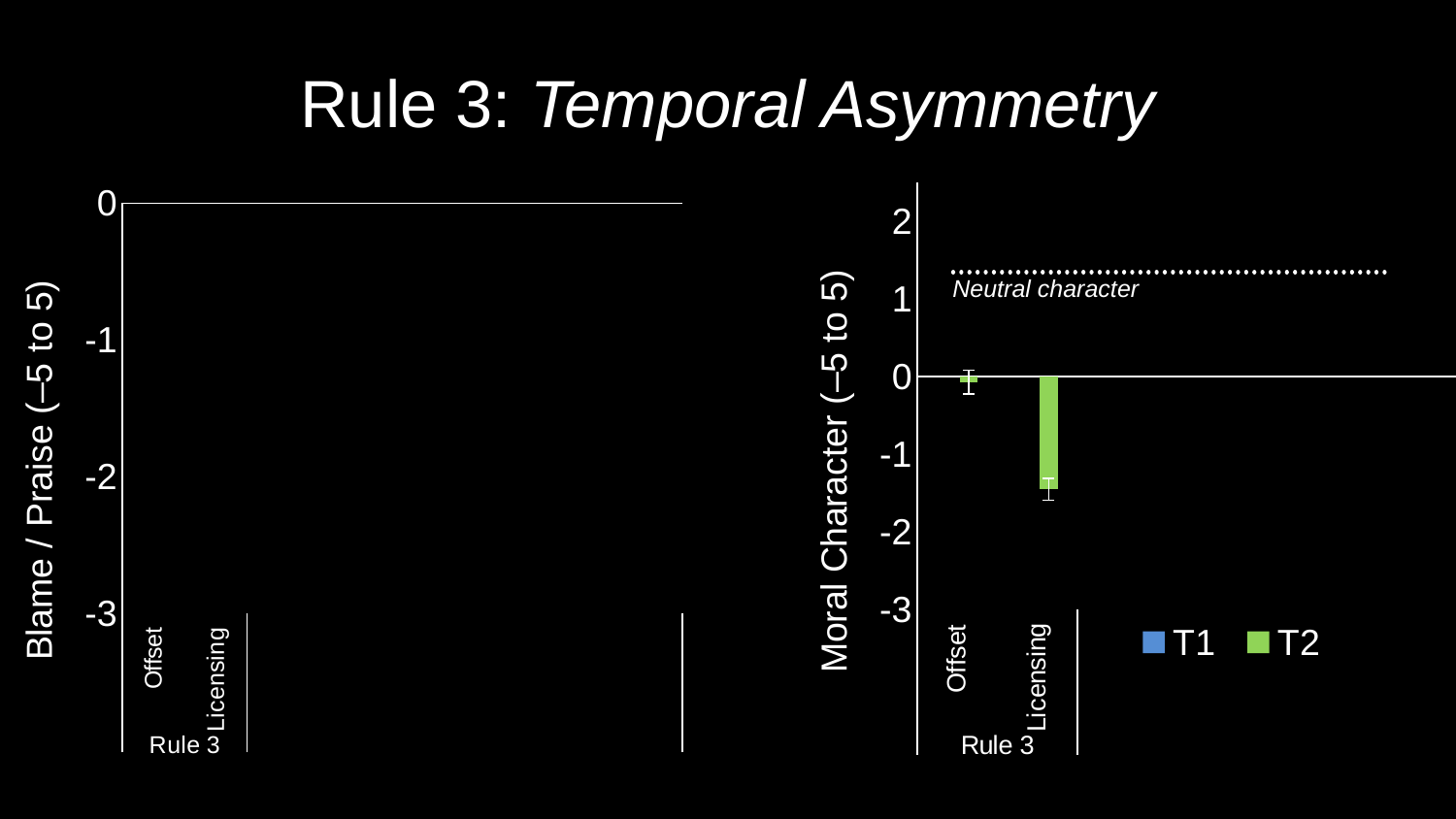
What is the y-axis label of the left-hand chart? Blame / Praise (–5 to 5) In the right-hand chart (Moral Character), what label is given to the dotted horizontal line? Neutral character In the right-hand chart (Moral Character), which has the larger T2 value, Offset or Licensing? Offset In the right-hand chart (Moral Character), how many series does the legend list? 2 What kind of chart is the right-hand chart (Moral Character)? bar chart In the right-hand chart (Moral Character), what are the two series named in the legend? T1 and T2 In the left-hand chart (Blame / Praise), how many categories are labelled on the x axis? 2 In the right-hand chart (Moral Character), is the T2 value for Licensing greater or less than -1? less In the right-hand chart (Moral Character), which category has the lowest T2 value? Licensing In the right-hand chart (Moral Character), how many categories are shown on the x axis? 2 In the right-hand chart (Moral Character), is the T2 value for Offset greater or less than -1? greater